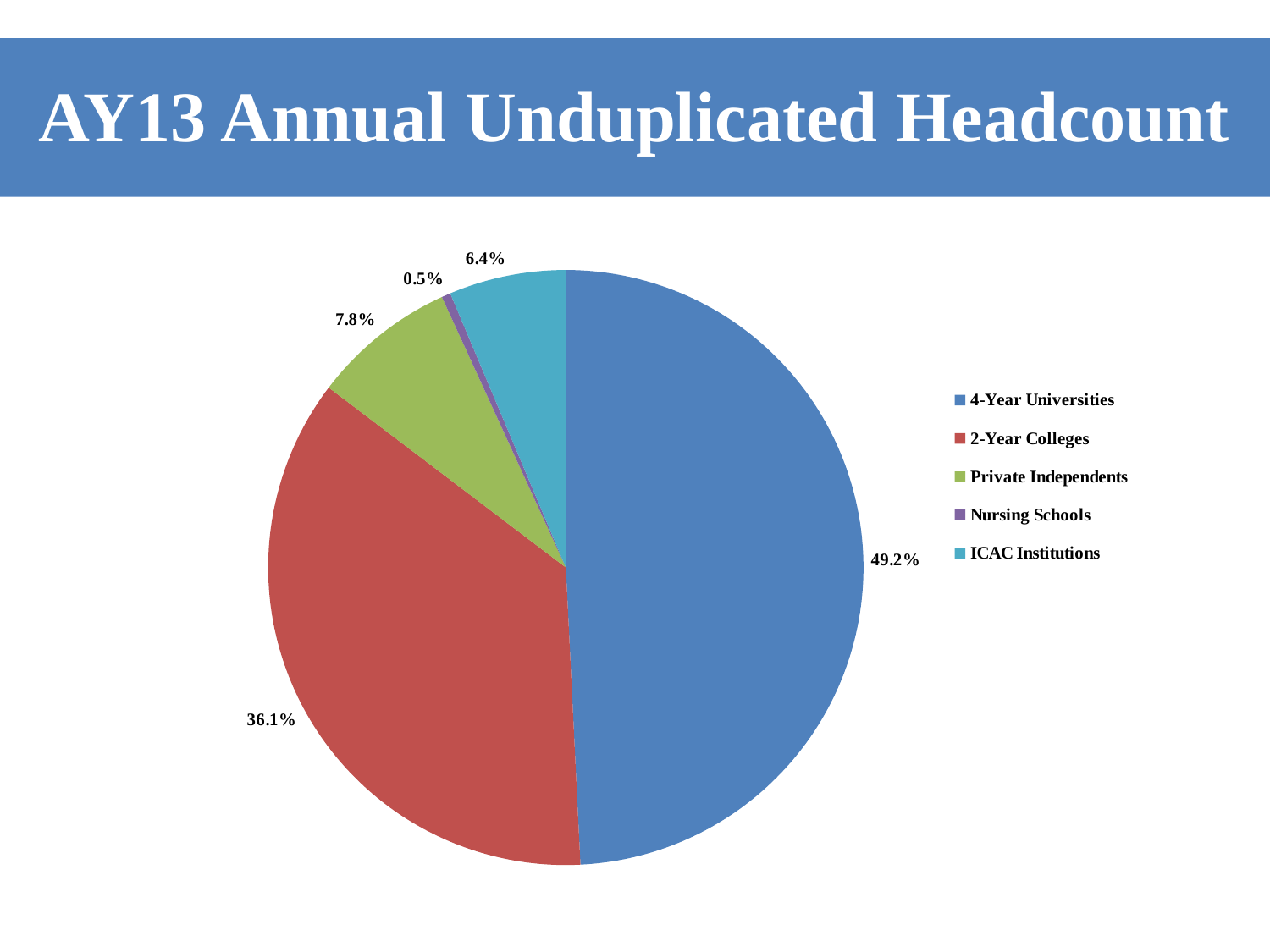
How many categories does the legend list? 5 What share of the pie do 4-Year Universities account for? 49.2% What share of the pie do 2-Year Colleges account for? 36.1% What is the difference in percentage points between 4-Year Universities and 2-Year Colleges? 13.1 What kind of chart is shown on the slide? Pie chart What share of the pie do ICAC Institutions account for? 6.4% Which category has the smallest slice of the pie? Nursing Schools What is the title of the slide? AY13 Annual Unduplicated Headcount Which category has the largest slice of the pie? 4-Year Universities Which is larger, the share for Private Independents or the share for ICAC Institutions? Private Independents